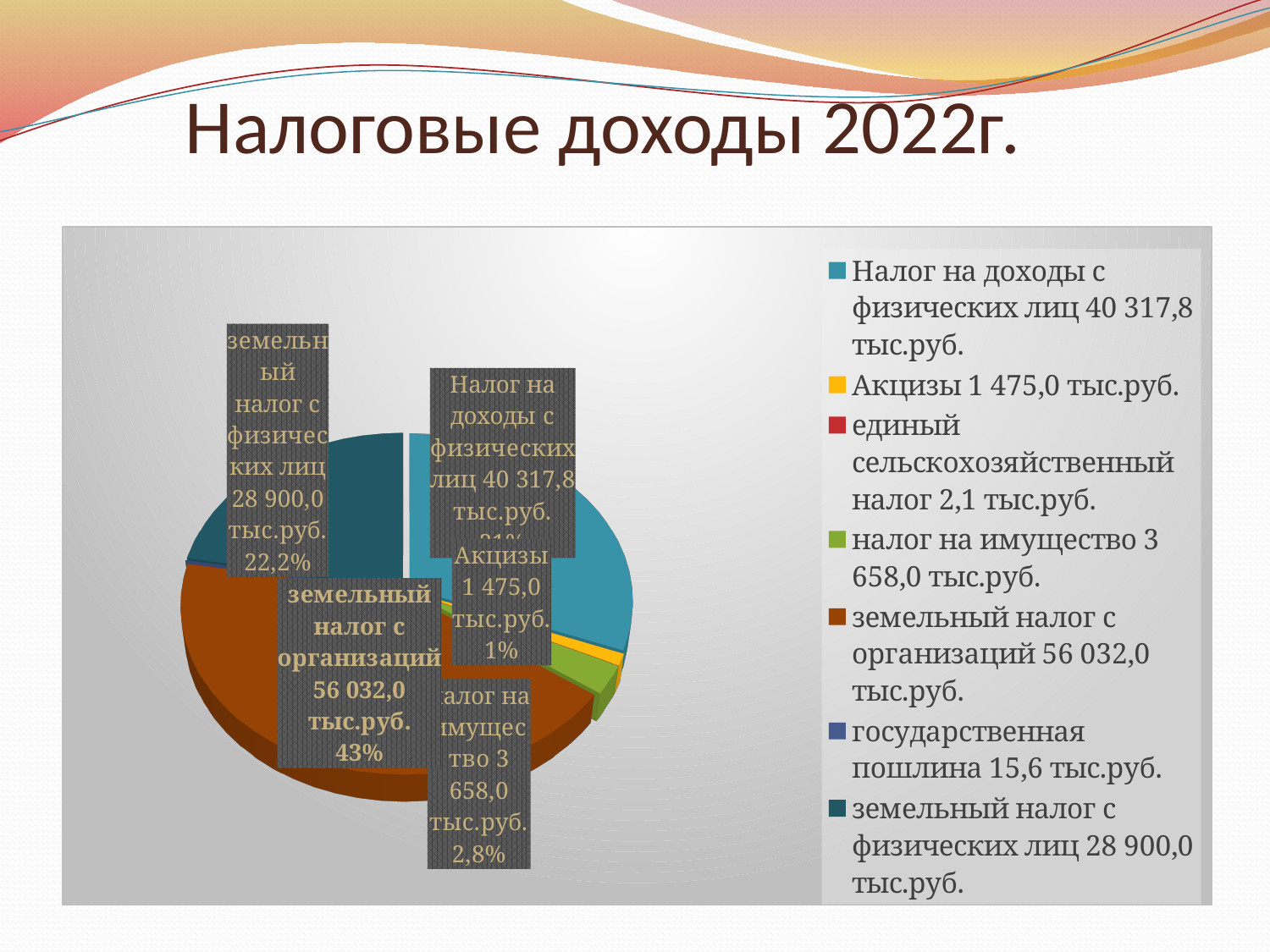
What is the value for государственная пошлина? 15,6 тыс.руб. What kind of chart is shown on the slide? pie chart What is the title of the chart on the slide? Налоговые доходы 2022г. Which category has the smallest value in the pie chart? единый сельскохозяйственный налог Which category has the largest value in the pie chart? земельный налог с организаций What is the value for Налог на доходы с физических лиц? 40 317,8 тыс.руб. What share of the pie does земельный налог с физических лиц represent? 22,2% Which is larger: Налог на доходы с физических лиц or земельный налог с физических лиц? Налог на доходы с физических лиц What share of the pie does земельный налог с организаций represent? 43% What is the value for земельный налог с организаций? 56 032,0 тыс.руб. How many categories does the legend of the pie chart list? 7 What is the difference between земельный налог с организаций and Налог на доходы с физических лиц? 15 714,2 тыс.руб.